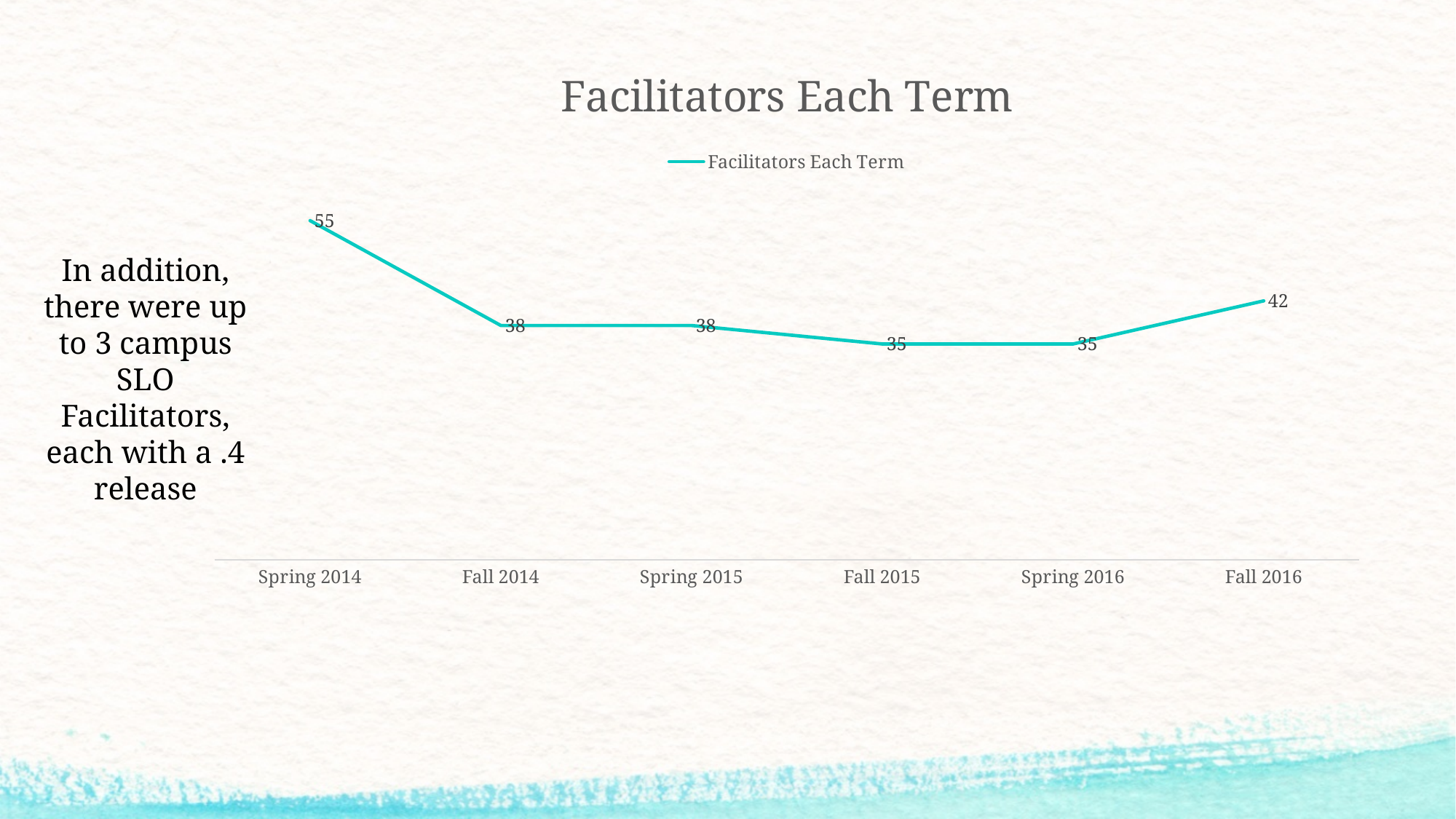
What is the title of the chart? Facilitators Each Term Which is larger, the value for Fall 2014 or the value for Fall 2016? Fall 2016 What is the value for Spring 2014? 55 How many terms are plotted on the x axis? 6 What is the value for Fall 2016? 42 What is the difference between the values for Spring 2014 and Fall 2014? 17 What is the value for Fall 2015? 35 What is the difference between the values for Fall 2016 and Spring 2016? 7 Does the value rise or fall from Spring 2014 to Fall 2014? Fall Which term has the highest number of facilitators? Spring 2014 How many series does the legend list? 1 What kind of chart is shown? Line chart